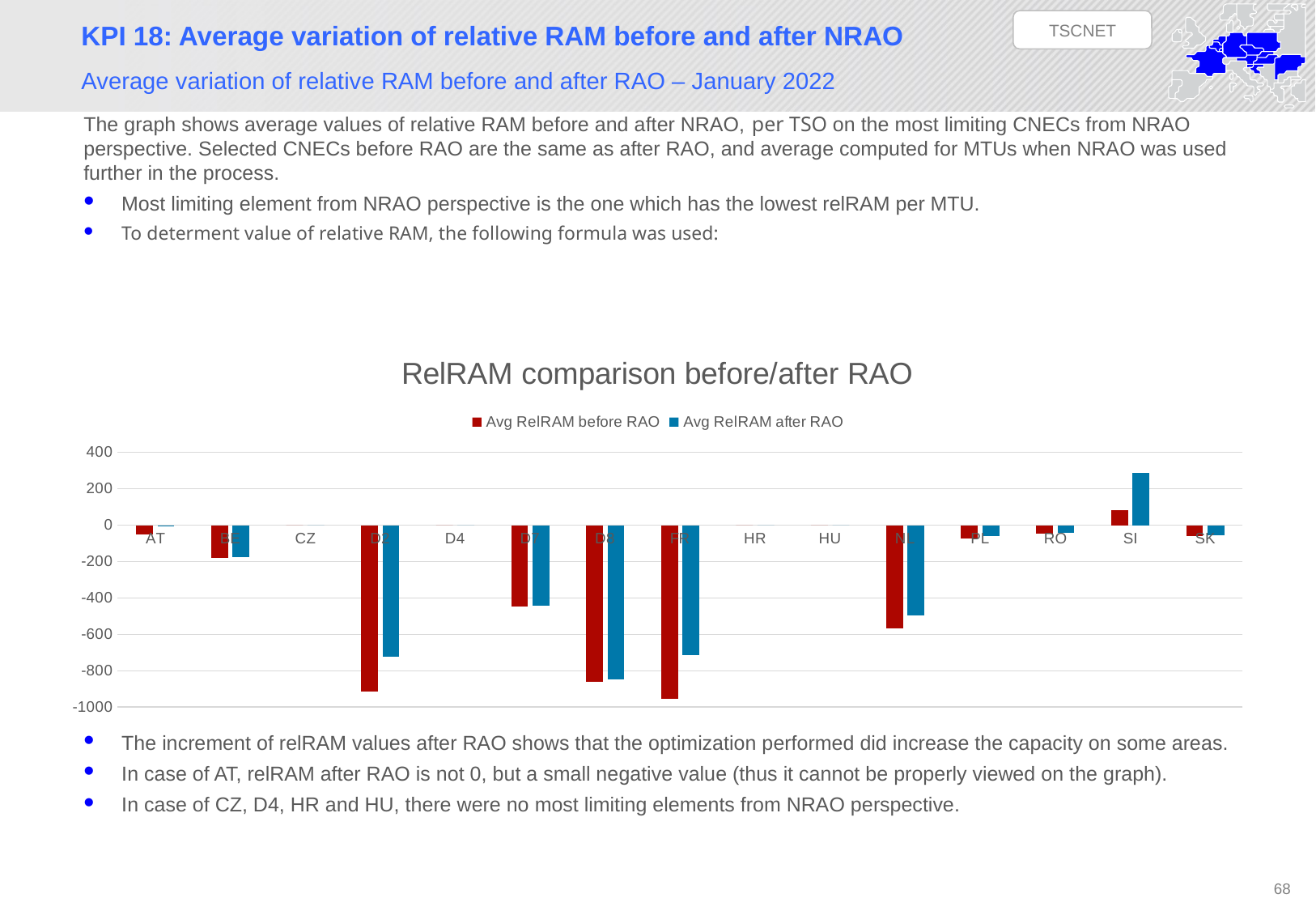
What is the title of the chart? RelRAM comparison before/after RAO For NL, which is larger: Avg RelRAM before RAO or Avg RelRAM after RAO? Avg RelRAM after RAO Is the Avg RelRAM before RAO value for NL greater or less than -400? less How many categories are shown on the x axis of the chart? 15 Which category has the highest Avg RelRAM after RAO value? SI For SI, which is larger: Avg RelRAM before RAO or Avg RelRAM after RAO? Avg RelRAM after RAO Which category has the highest Avg RelRAM before RAO value? SI How many series does the chart legend list? 2 What type of chart is shown on the slide? bar chart Which series is shown in blue in the chart? Avg RelRAM after RAO Is the Avg RelRAM before RAO value for BE greater or less than -400? greater Is the Avg RelRAM after RAO value for SI greater or less than 200? greater